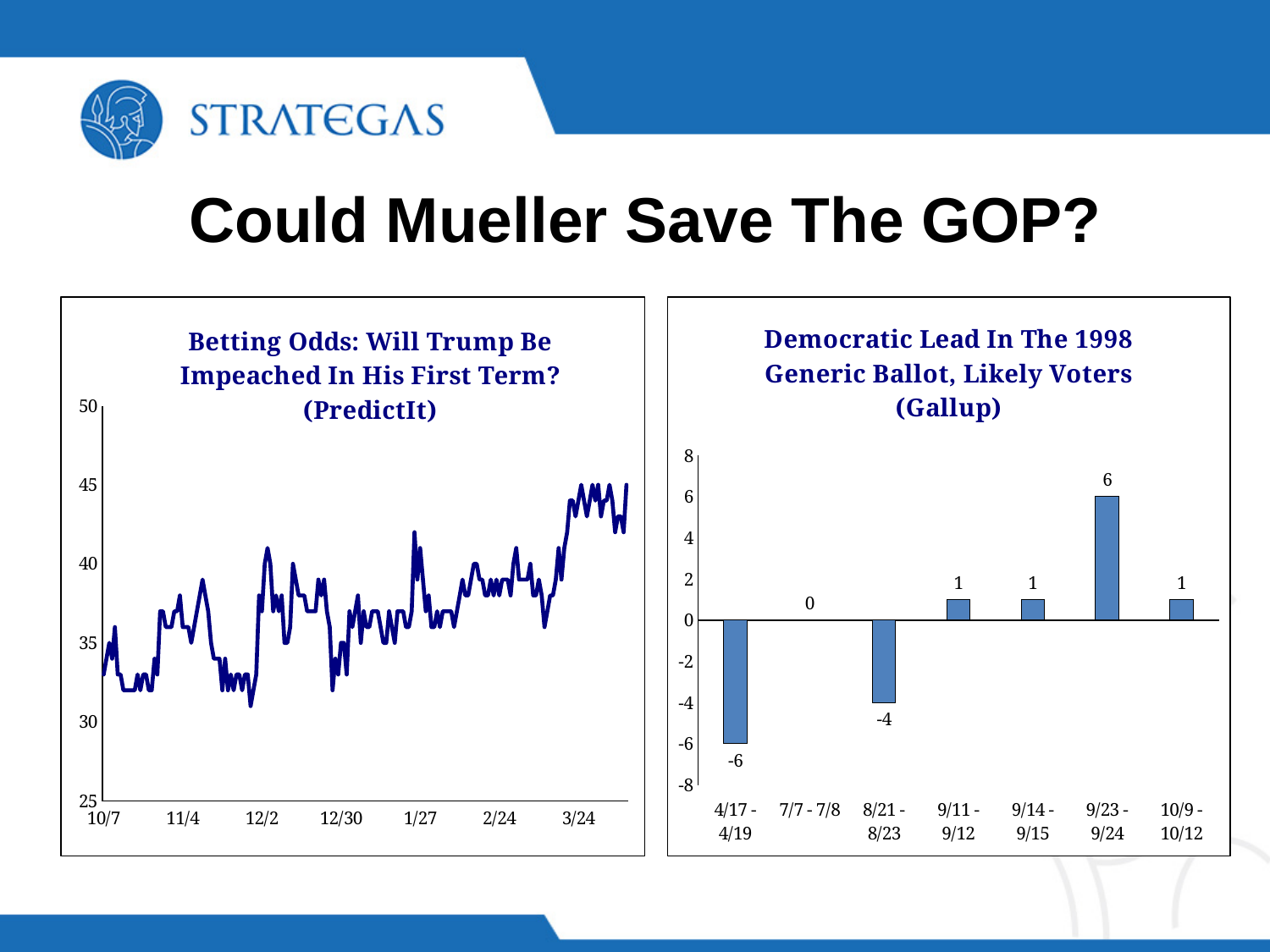
On the Democratic Lead In The 1998 Generic Ballot chart, which period has the highest value? 9/23 - 9/24 On the Betting Odds: Will Trump Be Impeached In His First Term? chart, is the value at 3/24 greater or less than 40? greater On the Democratic Lead In The 1998 Generic Ballot chart, what is the value for 4/17 - 4/19? -6 What kind of chart is the Democratic Lead In The 1998 Generic Ballot chart? bar chart On the Democratic Lead In The 1998 Generic Ballot chart, which is larger, the value for 7/7 - 7/8 or the value for 8/21 - 8/23? 7/7 - 7/8 On the Democratic Lead In The 1998 Generic Ballot chart, what is the value for 9/23 - 9/24? 6 On the Democratic Lead In The 1998 Generic Ballot chart, what is the difference between the values for 9/23 - 9/24 and 10/9 - 10/12? 5 How many periods are shown on the Democratic Lead In The 1998 Generic Ballot chart? 7 On the Betting Odds: Will Trump Be Impeached In His First Term? chart, do the values overall rise or fall from 10/7 to the end of the series? rise What kind of chart is the Betting Odds: Will Trump Be Impeached In His First Term? chart? line chart On the Democratic Lead In The 1998 Generic Ballot chart, what is the value for 8/21 - 8/23? -4 On the Democratic Lead In The 1998 Generic Ballot chart, which period has the lowest value? 4/17 - 4/19